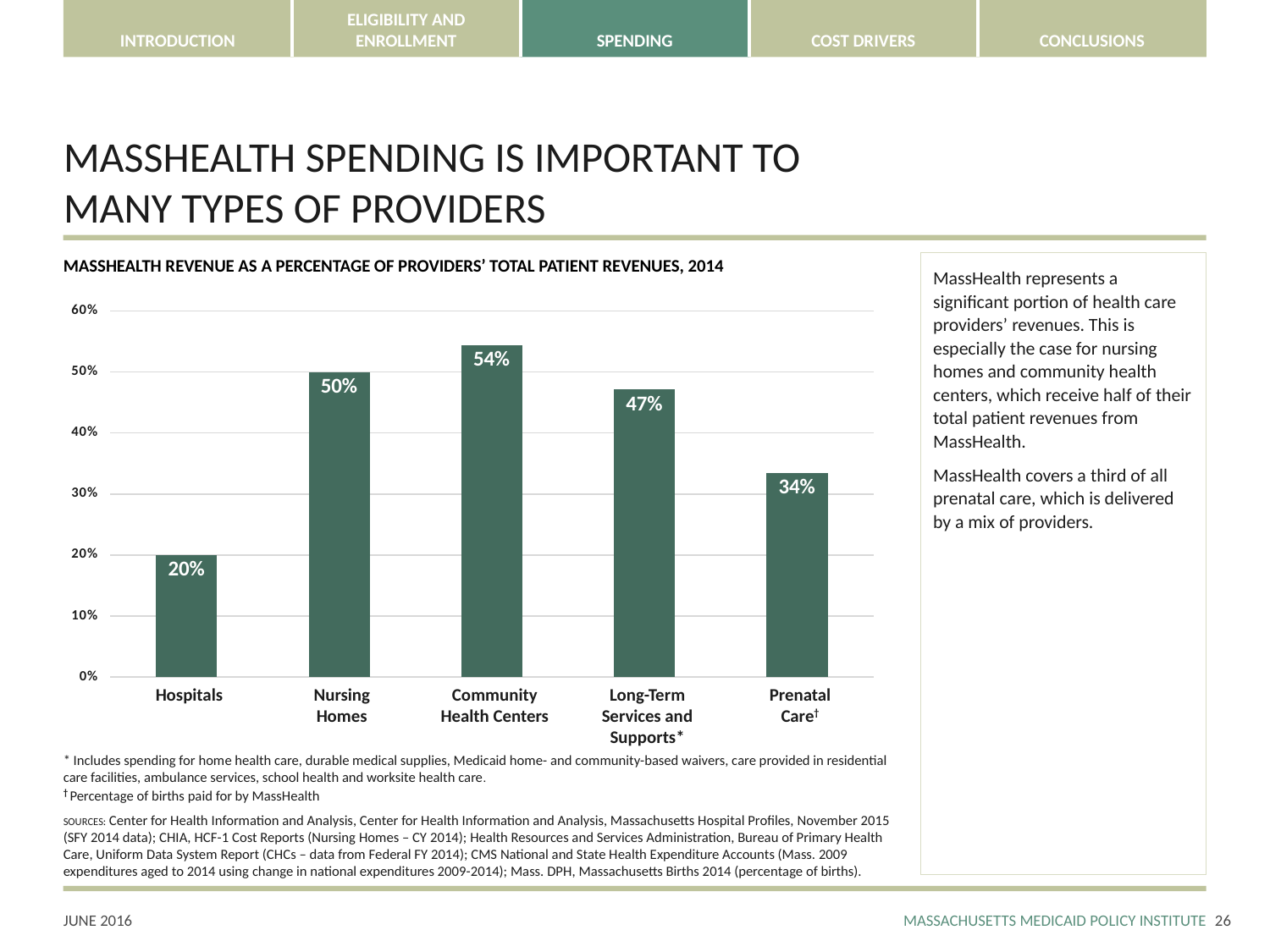
What is the difference in percentage points between Community Health Centers and Long-Term Services and Supports? 7 Is the value for Nursing Homes greater or less than 40%? greater Which provider type has the lowest MassHealth revenue percentage? Hospitals What is the MassHealth revenue percentage for Hospitals? 20% Which provider type has the highest MassHealth revenue percentage? Community Health Centers What is the MassHealth revenue percentage for Community Health Centers? 54% Which is larger, the value for Long-Term Services and Supports or the value for Prenatal Care? Long-Term Services and Supports How many provider categories are shown in the chart? 5 What is the value shown for Prenatal Care? 34% What is the difference in percentage points between Nursing Homes and Hospitals? 30 What is the title of the chart? MassHealth Revenue as a Percentage of Providers' Total Patient Revenues, 2014 What type of chart is shown on the slide? Bar chart